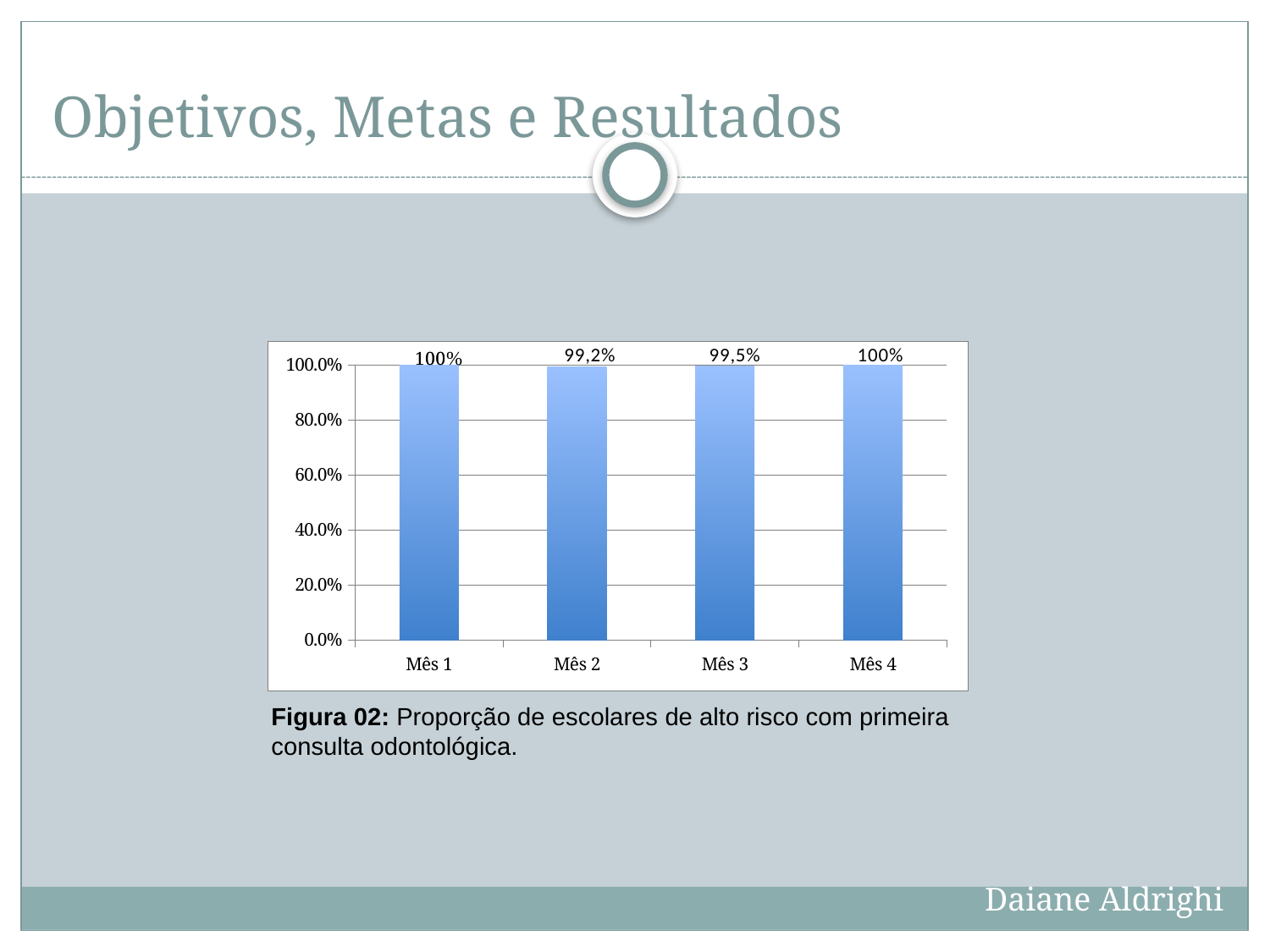
How many months are shown on the x axis? 4 Which month has the lowest value? Mês 2 What is the value for Mês 1? 100% Is the value for Mês 2 greater or less than 80.0%? greater Which is larger, the value for Mês 2 or the value for Mês 3? Mês 3 What is the difference between the value for Mês 3 and the value for Mês 2? 0,3% What is the figure number given in the caption below the chart? Figura 02 What is the difference between the value for Mês 1 and the value for Mês 2? 0,8% What is the value for Mês 4? 100% What is the value for Mês 3? 99,5% What is the value for Mês 2? 99,2% What kind of chart is shown on the slide? bar chart